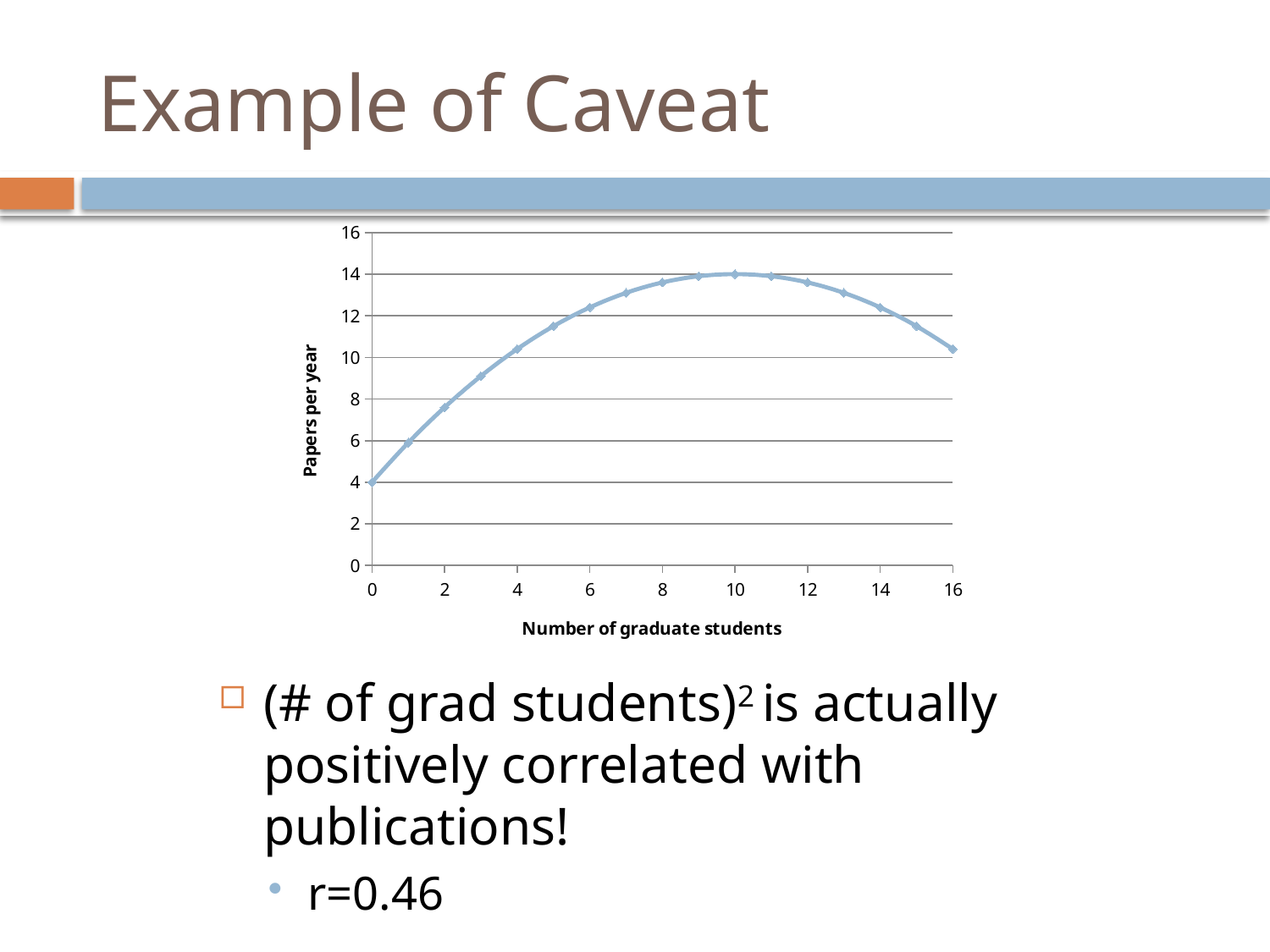
Is the value of papers per year at 16 graduate students greater or less than 12? less Which has more papers per year: 2 graduate students or 14 graduate students? 14 graduate students What is the title of the y axis? Papers per year What is the difference in papers per year between 10 graduate students and 0 graduate students? 10 At what number of graduate students is papers per year lowest? 0 What is the value of papers per year when the number of graduate students is 0? 4 How many data points are plotted on the line? 17 At what number of graduate students is papers per year highest? 10 How do papers per year change as the number of graduate students increases from 0 to 16? rise then fall What is the value of papers per year when the number of graduate students is 10? 14 What is the title of the x axis? Number of graduate students What kind of chart is shown on the slide? line chart